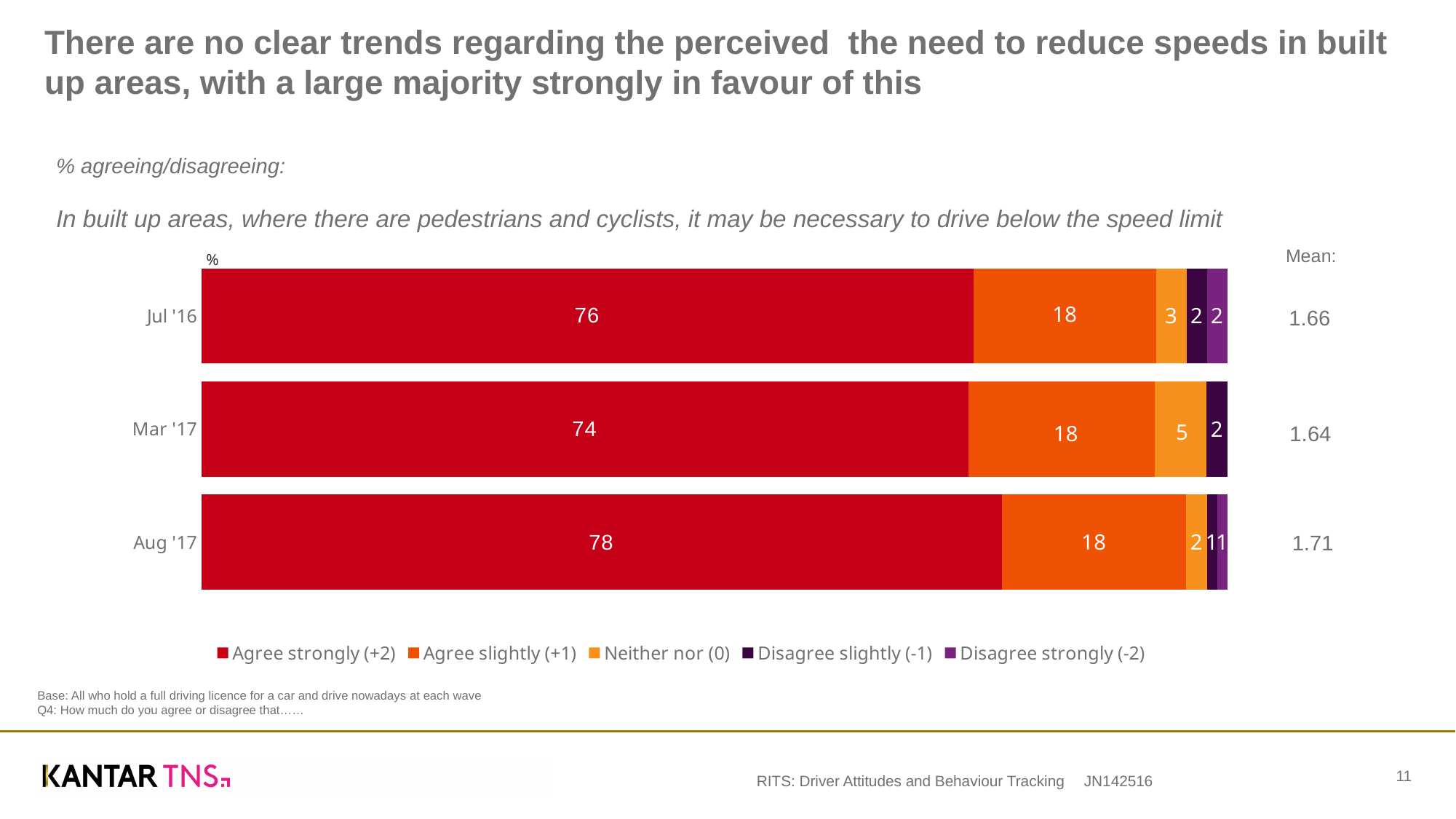
What is the mean score shown for Aug '17? 1.71 What type of chart is shown on the slide? stacked bar chart What is the difference between the 'Agree strongly (+2)' values for Aug '17 and Mar '17? 4 How many series does the legend list? 5 What is the 'Agree slightly (+1)' value for Mar '17? 18 Is the 'Neither nor (0)' value larger for Jul '16 or Aug '17? Jul '16 What percentage of respondents in Aug '17 agreed strongly that it may be necessary to drive below the speed limit in built up areas? 78 Which wave has the highest 'Agree strongly (+2)' percentage? Aug '17 What is the 'Neither nor (0)' value for Mar '17? 5 How many waves (bars) are shown in the chart? 3 What is the total of the labelled segments in the Aug '17 bar? 100 Which wave has the lowest 'Agree strongly (+2)' percentage? Mar '17